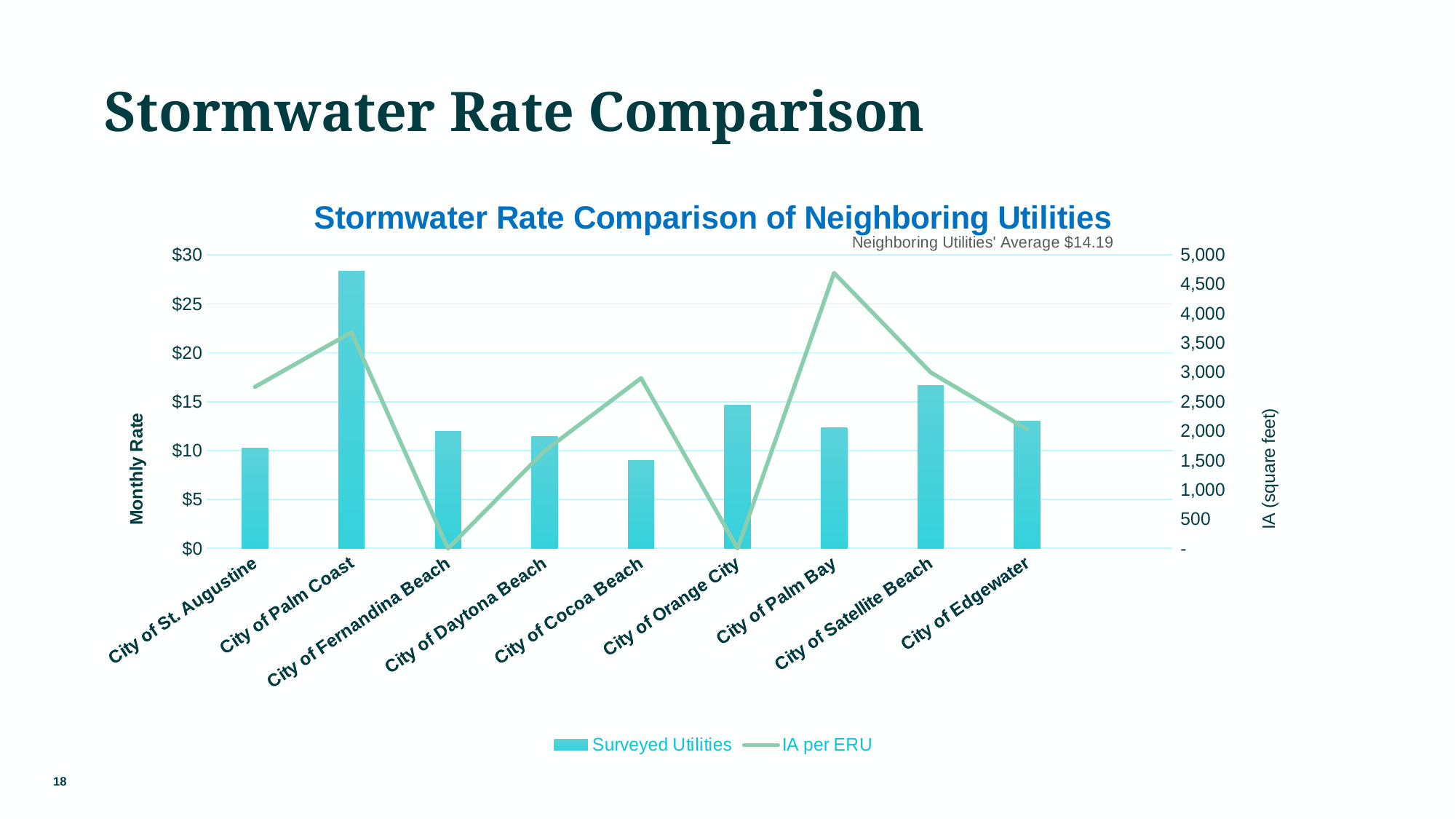
How many series does the legend list? 2 Which has the larger Surveyed Utilities monthly rate, City of Satellite Beach or City of Daytona Beach? City of Satellite Beach Which city has the highest IA per ERU value? City of Palm Bay Is the Surveyed Utilities monthly rate for City of Palm Coast greater or less than $25? greater Which city has the highest Surveyed Utilities monthly rate? City of Palm Coast Is the Surveyed Utilities monthly rate for City of Cocoa Beach greater or less than $10? less Which city has the lowest Surveyed Utilities monthly rate? City of Cocoa Beach How many cities are shown on the x axis? 9 What is the title of the chart? Stormwater Rate Comparison of Neighboring Utilities Is the IA per ERU value for City of Palm Bay greater or less than 4,500? greater What is the Neighboring Utilities' Average shown on the chart? $14.19 What kind of chart is this? Combined bar and line chart